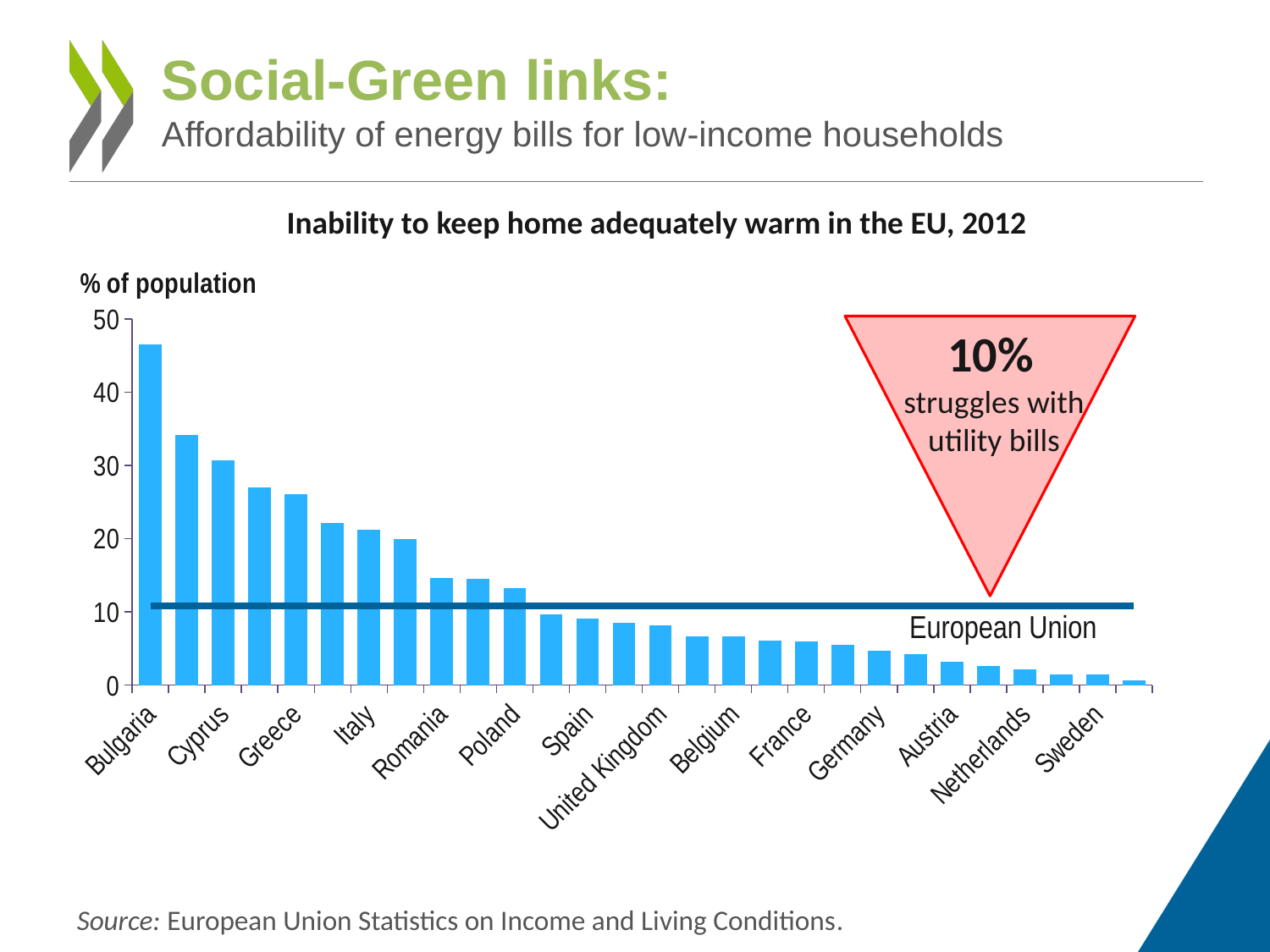
Which has a higher value, Italy or Spain? Italy What is the title of the chart? Inability to keep home adequately warm in the EU, 2012 What type of chart is shown on the slide? bar chart Is the value for Italy greater or less than 20? greater Is the value for Sweden greater or less than 10? less Is the value for Bulgaria greater or less than 40? greater What is the label on the vertical axis of the chart? % of population Which country has the highest value in the chart? Bulgaria Do the bar values rise or fall moving from left to right along the x axis? fall